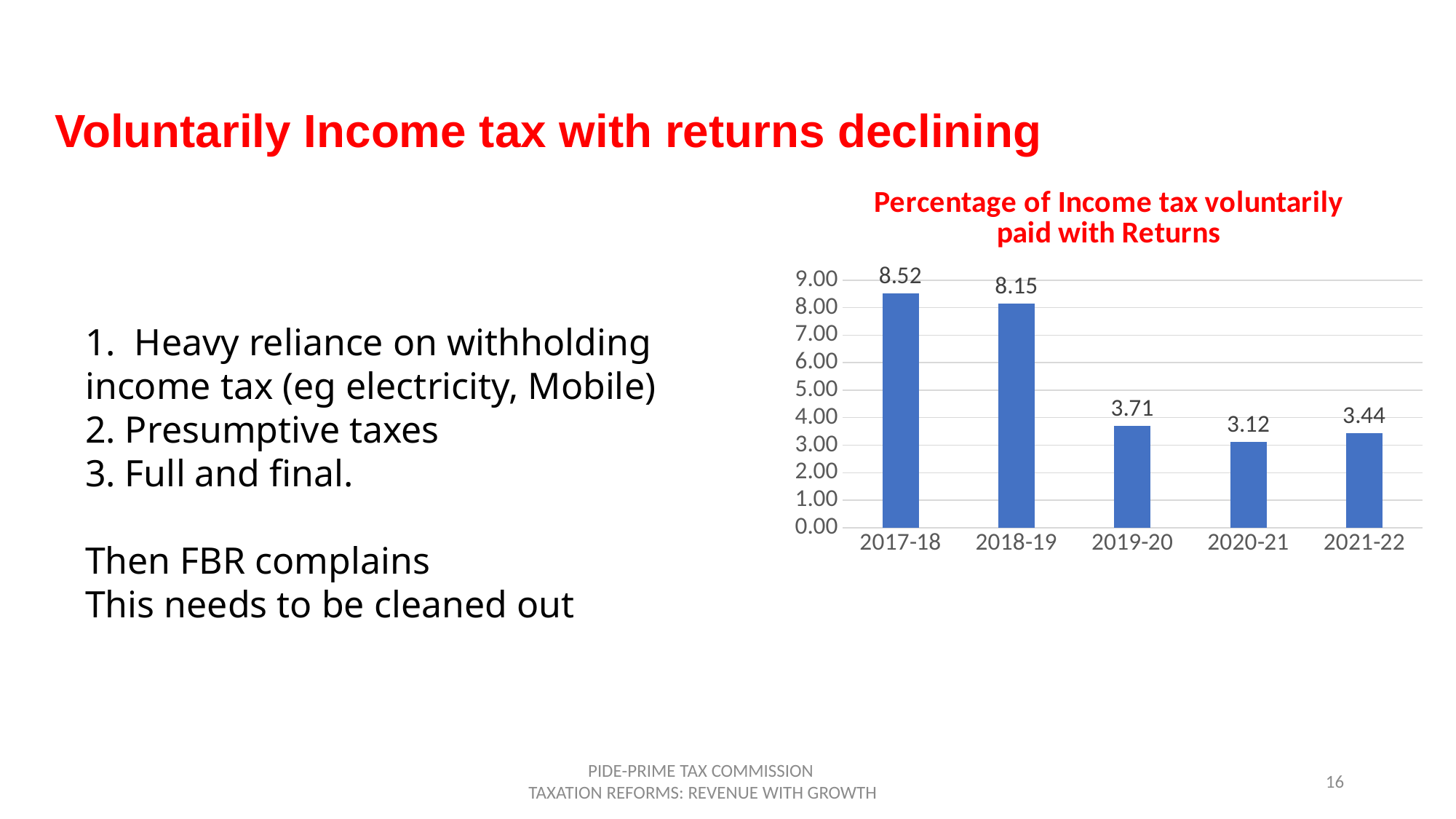
Do the values generally rise or fall from 2017-18 to 2021-22? fall Is the value for 2018-19 greater or less than 5.00? greater What kind of chart is shown? bar chart Which year has the lowest value? 2020-21 What is the value for 2017-18? 8.52 What is the value for 2019-20? 3.71 What is the title of the chart? Percentage of Income tax voluntarily paid with Returns How many years are shown on the x axis? 5 What is the value for 2021-22? 3.44 Which is larger, the value for 2020-21 or the value for 2021-22? 2021-22 What is the difference between the values for 2018-19 and 2019-20? 4.44 Which year has the highest value? 2017-18